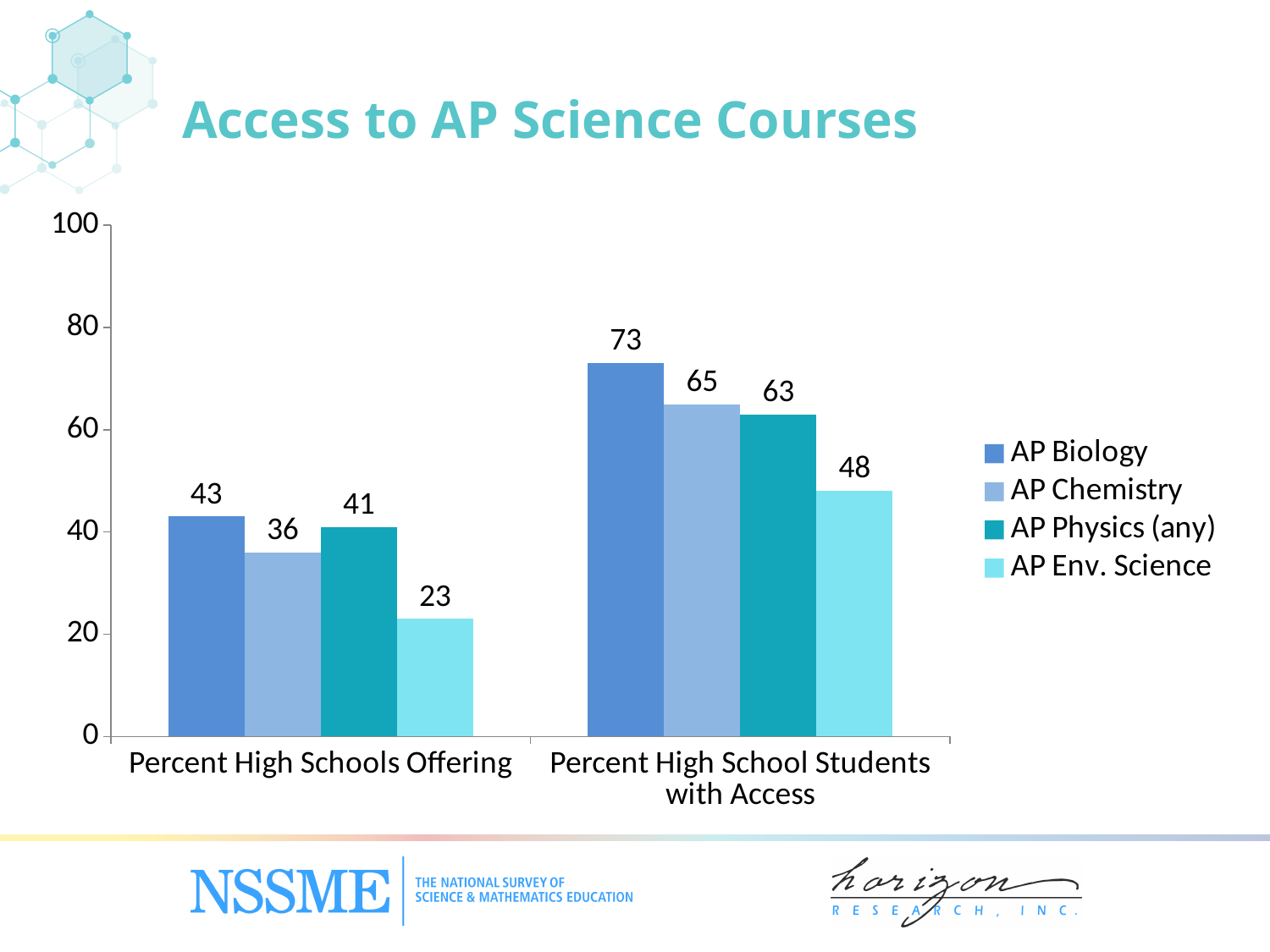
What is the value for AP Chemistry in the Percent High Schools Offering category? 36 Which series has the lowest value in the Percent High Schools Offering category? AP Env. Science What kind of chart is shown on the slide? Bar chart How many series does the legend list? 4 What is the value for AP Env. Science in the Percent High School Students with Access category? 48 Which is larger in the Percent High Schools Offering category: AP Biology or AP Physics (any)? AP Biology How many categories are shown on the x axis? 2 What is the difference between AP Physics (any) and AP Env. Science in the Percent High School Students with Access category? 15 What is the value for AP Biology in the Percent High Schools Offering category? 43 What is the title of the chart? Access to AP Science Courses Which series has the highest value in the Percent High School Students with Access category? AP Biology What is the difference between the AP Biology values for Percent High School Students with Access and Percent High Schools Offering? 30